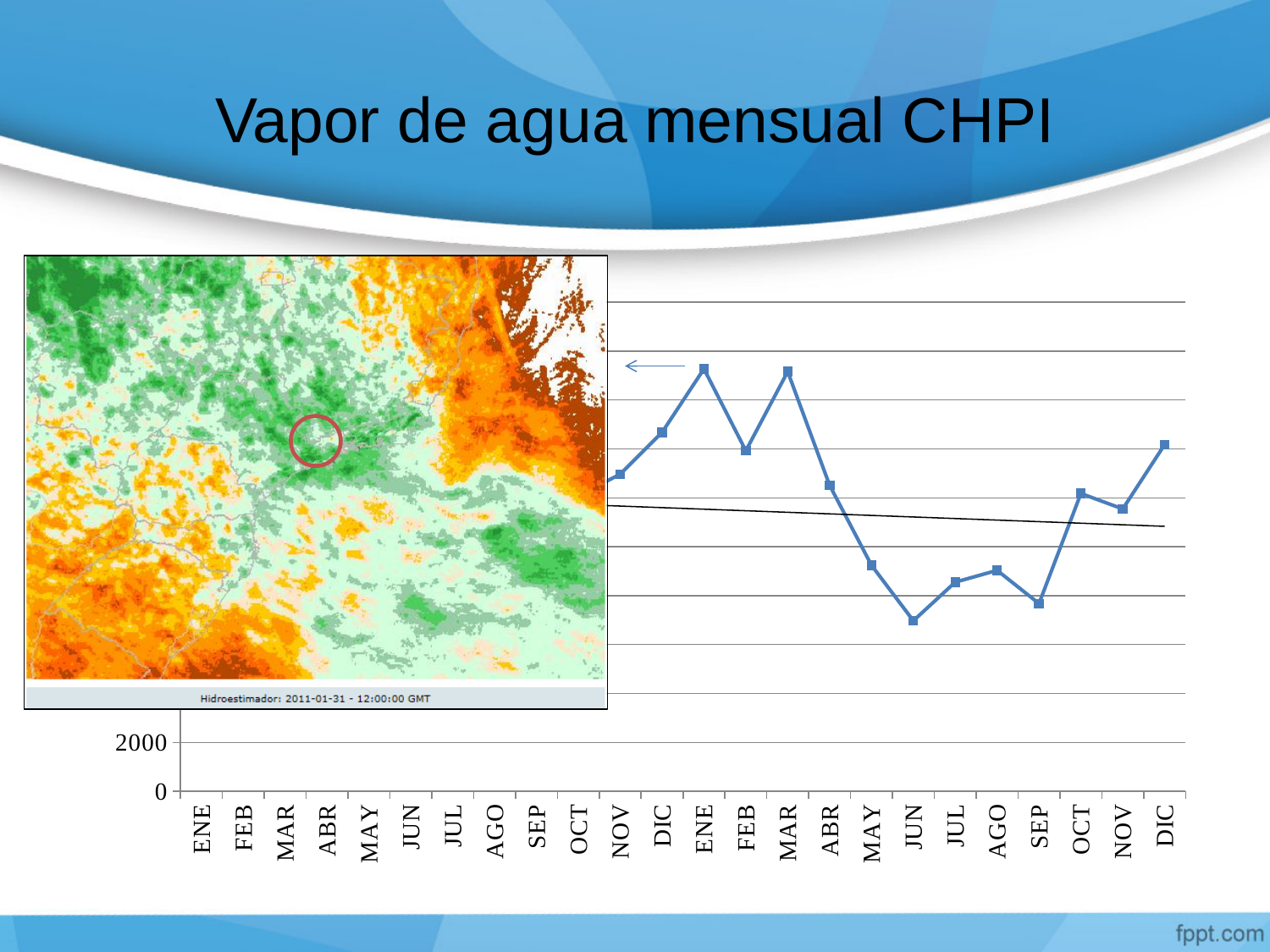
How many month labels are shown along the x axis of the chart? 24 Do the values rise or fall from the first NOV to the second ENE on the x axis? rise What is the title of the slide containing the chart? Vapor de agua mensual CHPI Which is larger, the value for the second ENE or the value for the second FEB on the x axis? ENE Which is larger, the value for the second MAR or the value for the second ABR on the x axis? MAR What kind of chart is shown on the slide? line chart Do the values rise or fall from the second MAR to the second JUN on the x axis? fall Is the value for the second JUN on the x axis greater or less than 2000? greater Is the value for the second SEP on the x axis greater or less than 2000? greater How many times does the label ENE appear on the x axis? 2 Which is larger, the value for the second MAY or the value for the second JUN on the x axis? MAY